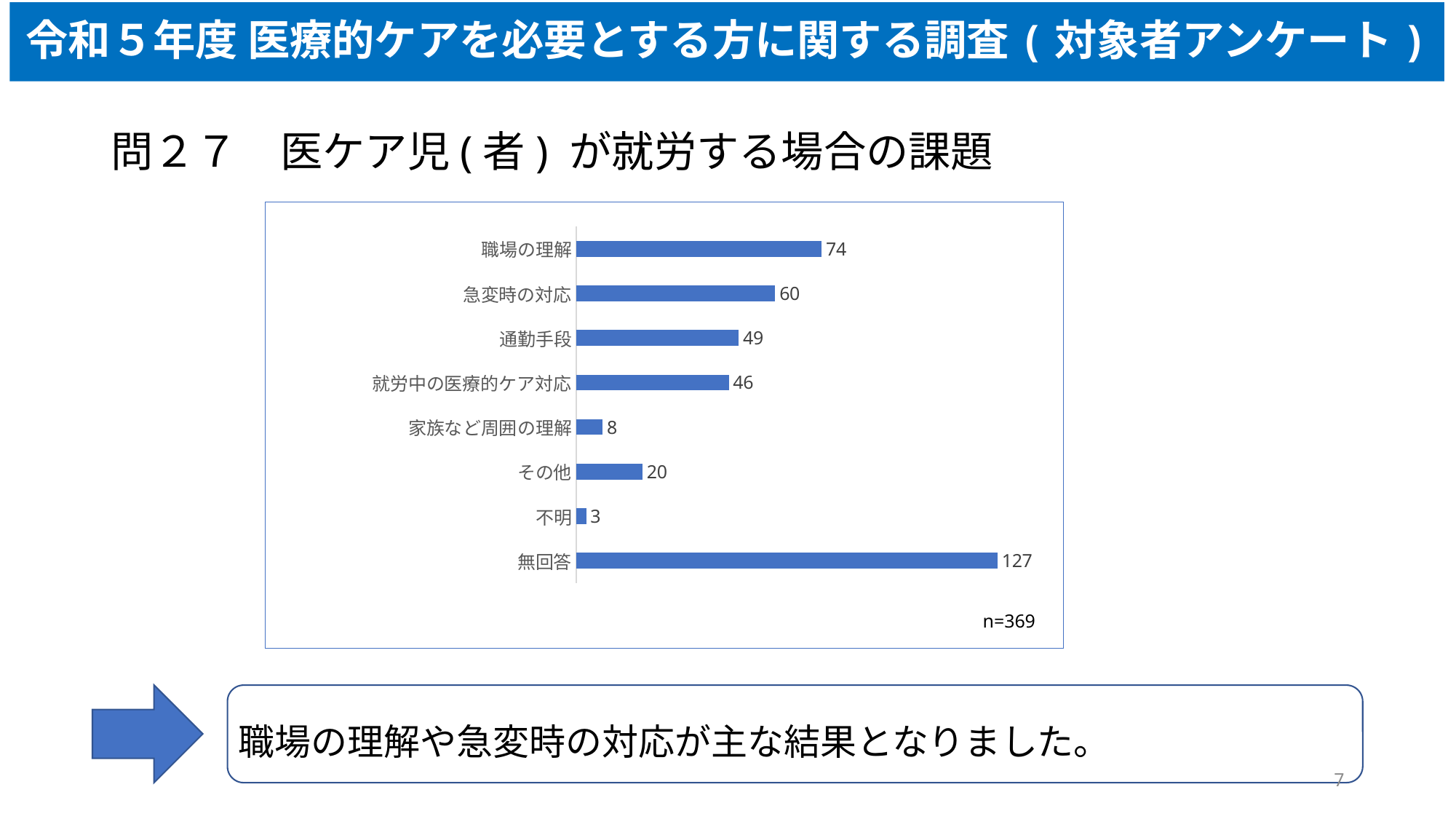
Which category has the lowest value? 不明 What kind of chart is shown on the slide? Bar chart What is the value for 急変時の対応? 60 Which is larger, the value for その他 or the value for 家族など周囲の理解? その他 What is the value for 職場の理解? 74 What sample size (n) is shown on the chart? n=369 How many categories are shown in the chart? 8 What is the value for 就労中の医療的ケア対応? 46 What is the value for 通勤手段? 49 What is the value for 家族など周囲の理解? 8 Which category has the highest value? 無回答 What is the difference between the values for 職場の理解 and 急変時の対応? 14